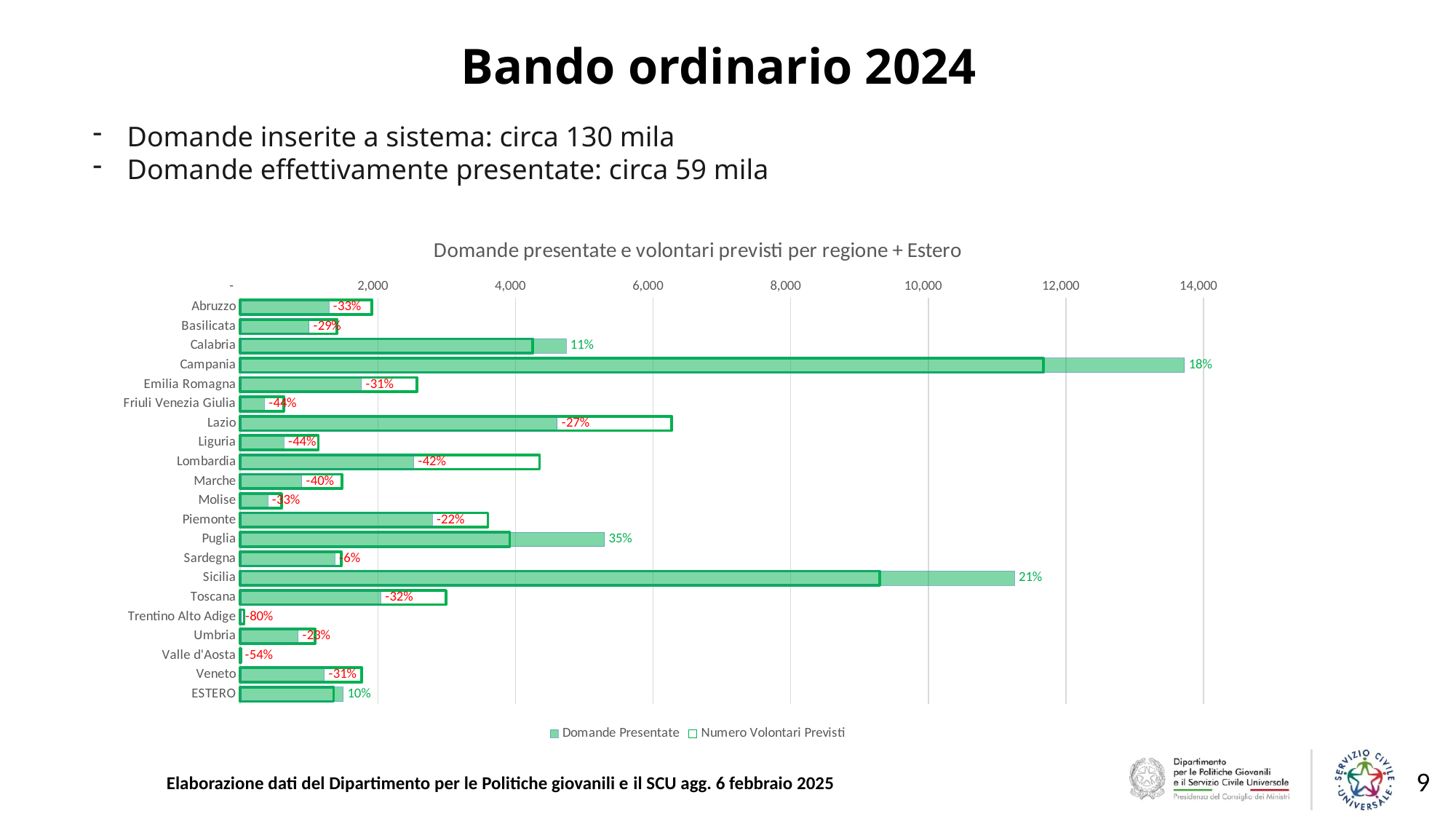
Which category has the lowest percentage label on the chart? Trentino Alto Adige What percentage label is shown next to the bar for Trentino Alto Adige? -80% Which has the larger Domande Presentate value, Sicilia or Puglia? Sicilia What is the title of the chart? Domande presentate e volontari previsti per regione + Estero Is the Domande Presentate value for Sicilia greater or less than 10,000? greater What percentage label is shown next to the bar for Lombardia? -42% What percentage label is shown next to the bar for Campania? 18% What percentage label is shown next to the bar for Puglia? 35% What kind of chart is shown on the slide? Bar chart How many series does the chart legend list? 2 Which category has the highest value for Domande Presentate? Campania How many categories (regions plus Estero) are plotted on the chart? 21